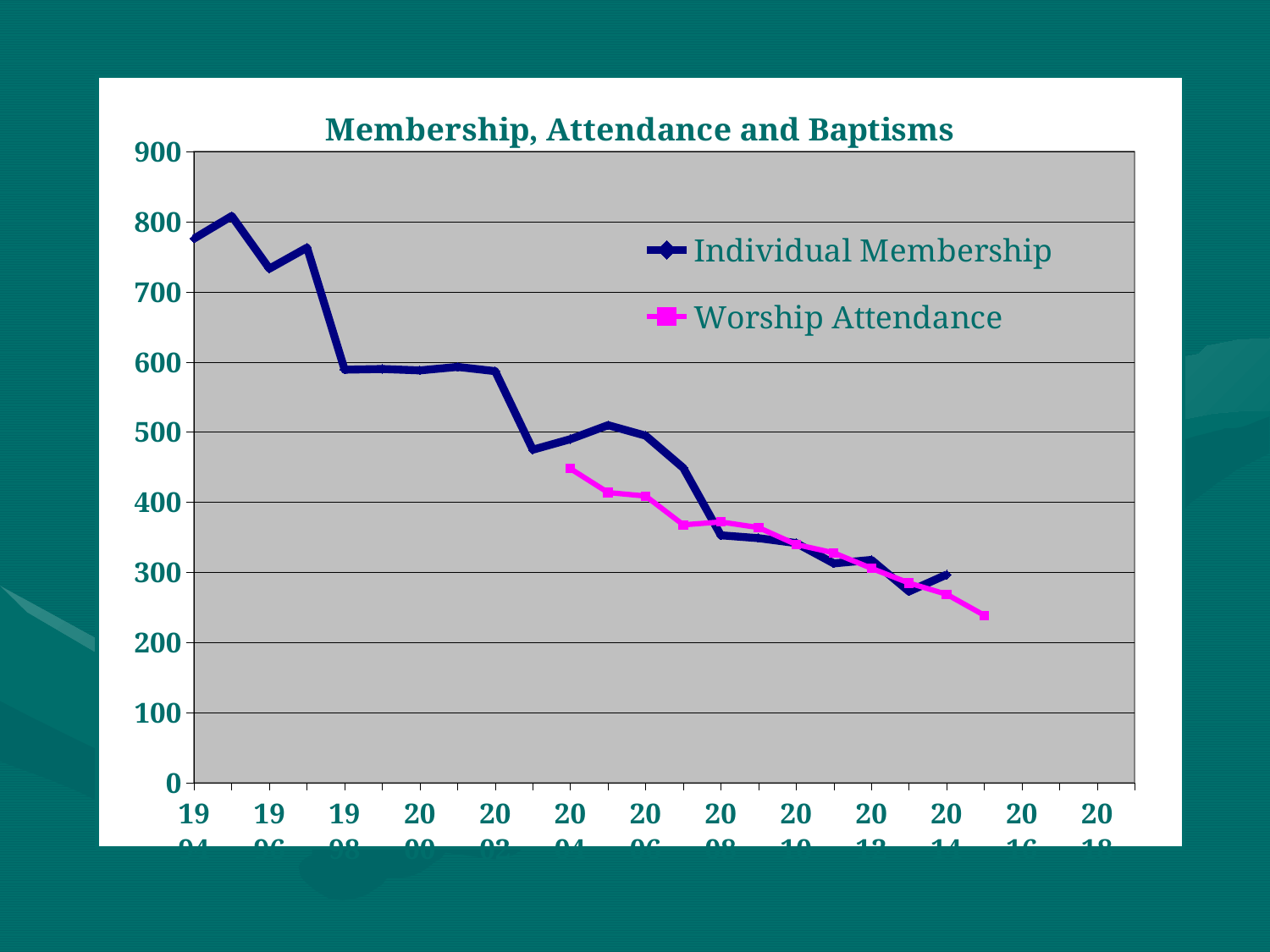
What is the overall trend of the Individual Membership line from left to right? falling What is the title of the chart? Membership, Attendance and Baptisms Is the first plotted value for Worship Attendance greater or less than 400? greater What is the overall trend of the Worship Attendance line from left to right? falling Which series is drawn in magenta? Worship Attendance Is the value for Individual Membership in 2000 greater or less than 500? greater What kind of chart is shown on the slide? line chart In 2006, which is larger: Individual Membership or Worship Attendance? Individual Membership Which series reaches the highest value on the chart? Individual Membership Is the last plotted value for Worship Attendance greater or less than 300? less How many series does the legend list? 2